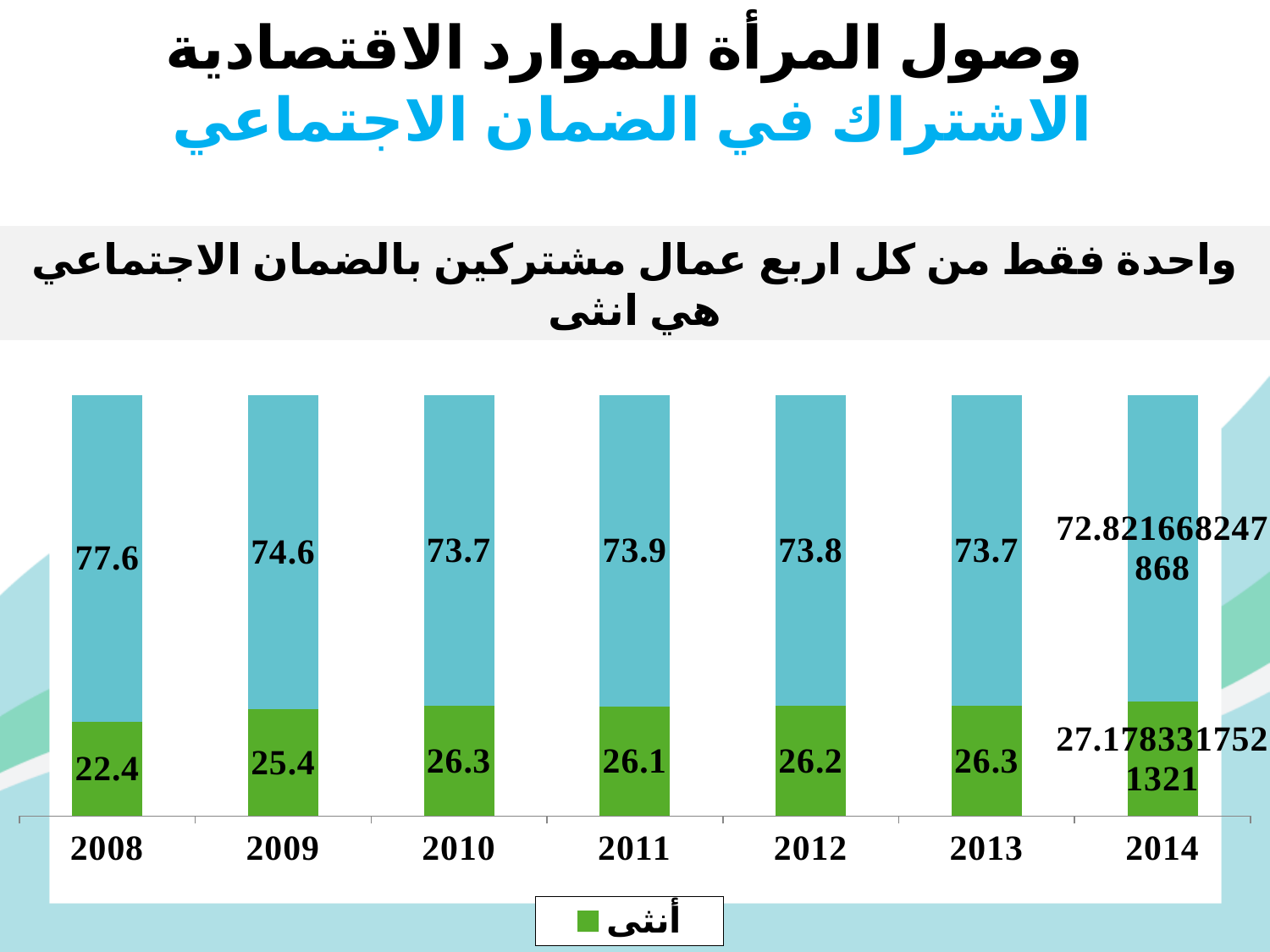
What is the value of the أنثى (green) segment for 2013? 26.3 Which year has the lowest value for the أنثى (green) segment? 2008 Which year has the highest value for the upper blue segment? 2008 Which year has the larger أنثى (green) value, 2009 or 2010? 2010 How many series does the chart legend list? 1 What is the value of the upper blue segment for 2012? 73.8 What is the value of the upper blue segment for 2009? 74.6 What is the value of the أنثى (green) segment for 2008? 22.4 What is the total of the stacked bar for 2008? 100 What kind of chart is shown on the slide? Stacked bar chart How many years are shown on the x axis of the chart? 7 What is the difference between the blue segment and the green أنثى segment in 2008? 55.2